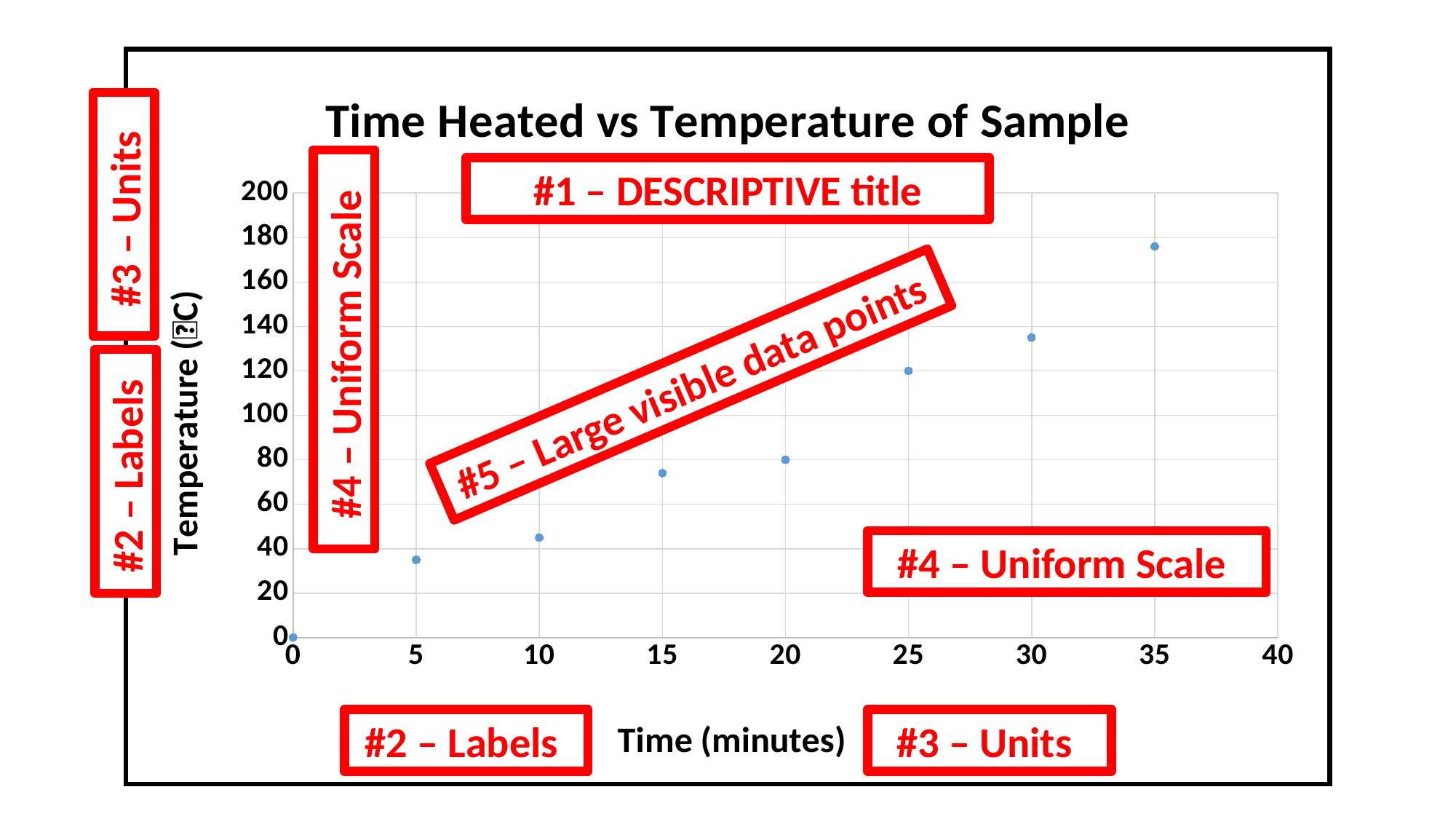
At which time (in minutes) is the temperature lowest? 0 What is the title of the chart? Time Heated vs Temperature of Sample Do the temperature values rise or fall as time increases along the x axis? Rise What type of chart is shown on the slide? Scatter chart Is the temperature at 10 minutes greater or less than 60? less Is the temperature at 15 minutes greater or less than 60? greater At which time (in minutes) is the temperature highest? 35 How many data points are plotted on the chart? 8 What is the x-axis title of the chart? Time (minutes) Is the temperature at 30 minutes greater or less than 120? greater Which has a higher temperature: the point at 25 minutes or the point at 15 minutes? 25 minutes